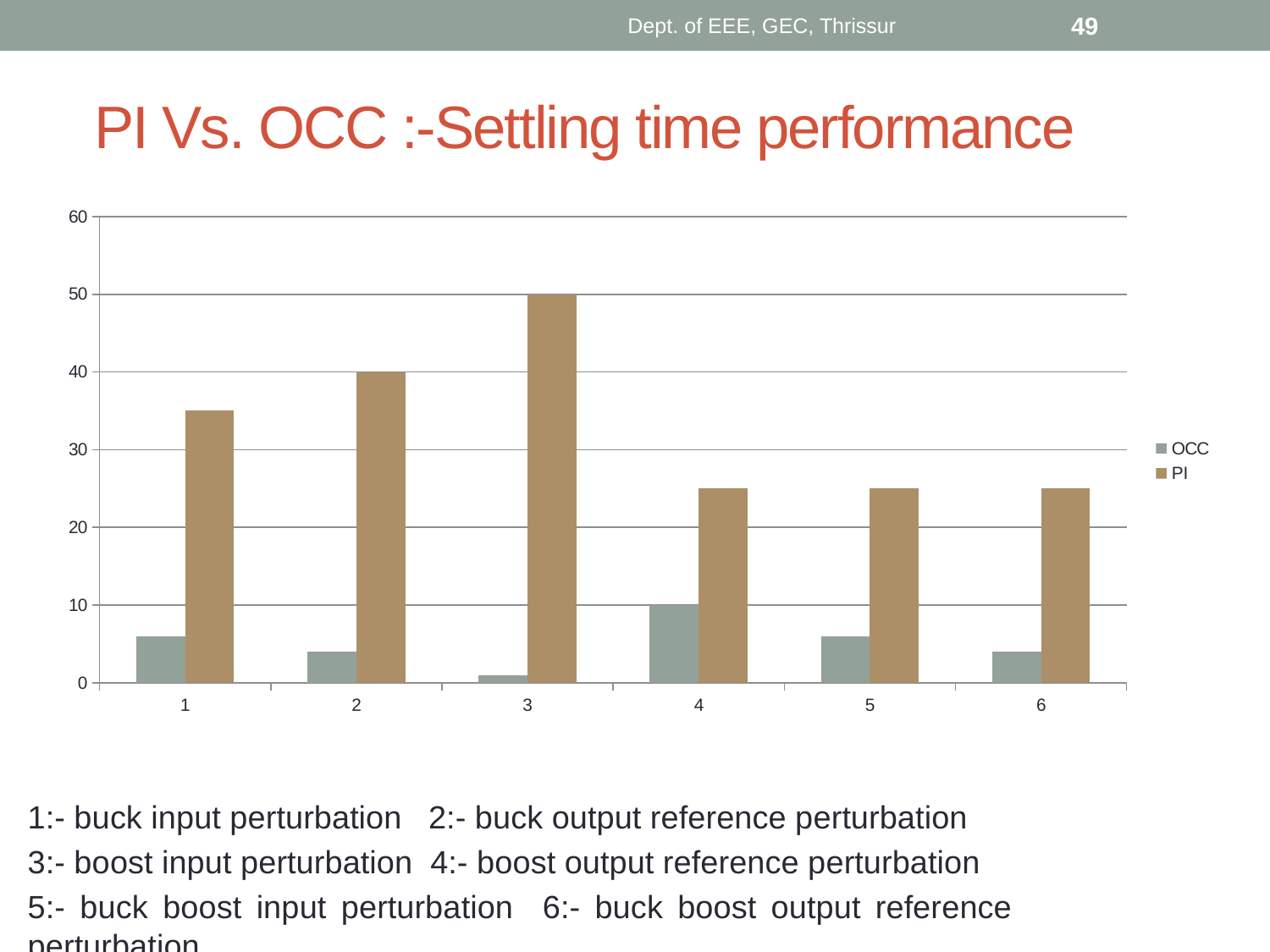
How many categories are shown on the x axis? 6 Which category has the lowest OCC value? 3 What is the PI value for category 2? 40 How many series does the legend list? 2 Is the PI value for category 1 greater or less than 30? greater What type of chart is shown on the slide? bar chart What is the OCC value for category 4? 10 What is the PI value for category 3? 50 For category 1, which series has the larger value, OCC or PI? PI Which category has the highest OCC value? 4 Is the PI value for category 5 greater or less than 30? less Which category has the highest PI value? 3